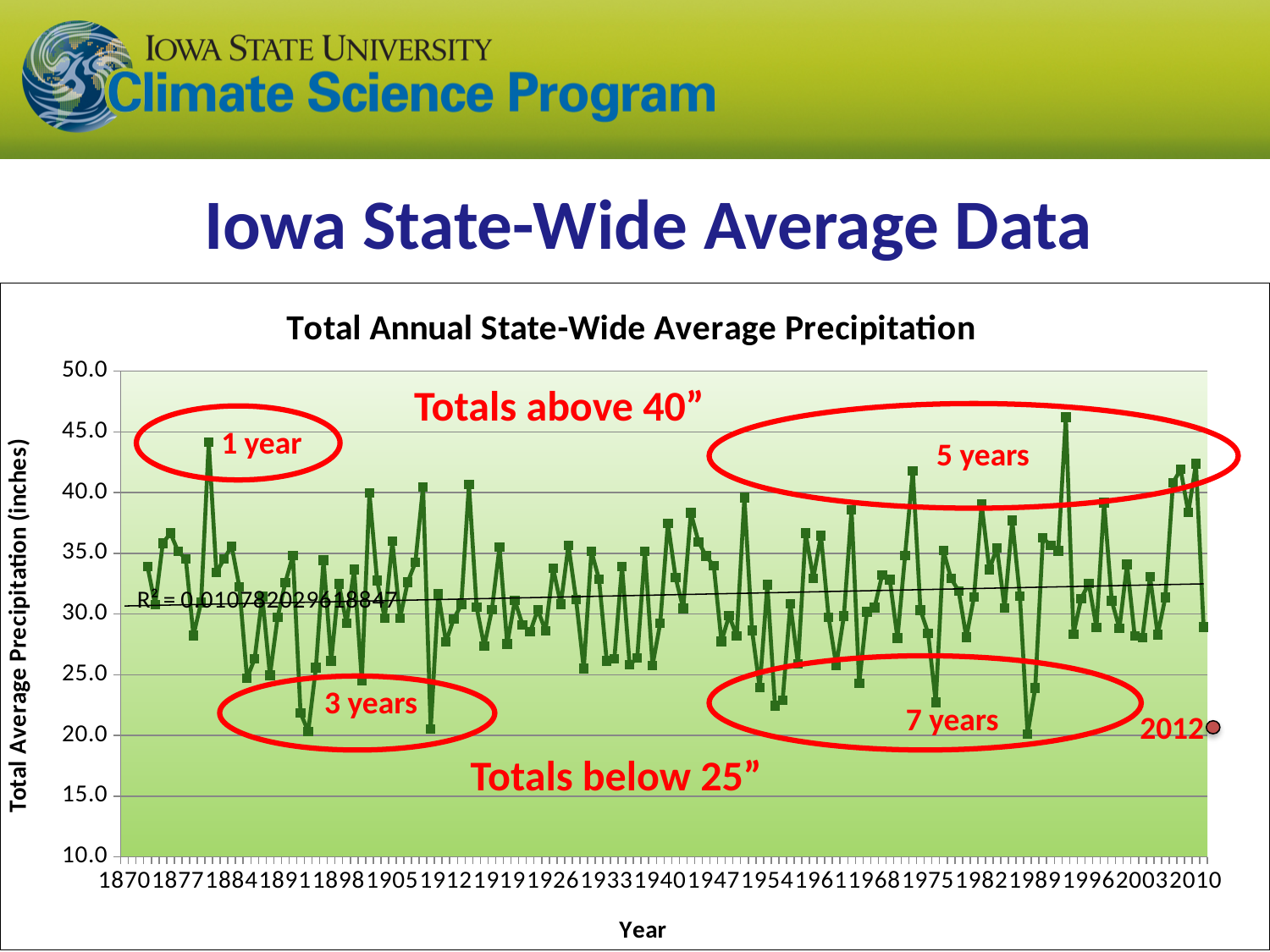
What kind of chart is shown on the slide? Line chart What is the first year shown on the x axis of the chart? 1870 Is the lowest point on the line greater or less than 25? less What is the highest value shown on the vertical axis of the chart? 50.0 What is the title of the chart? Total Annual State-Wide Average Precipitation What is the last year label shown on the x axis of the chart? 2010 Is the highest point on the line greater or less than 40? greater According to the annotation on the chart, how many years in the rightmost circled group had totals above 40 inches? 5 years What is the lowest value shown on the vertical axis of the chart? 10.0 What is the label on the vertical axis of the chart? Total Average Precipitation (inches)